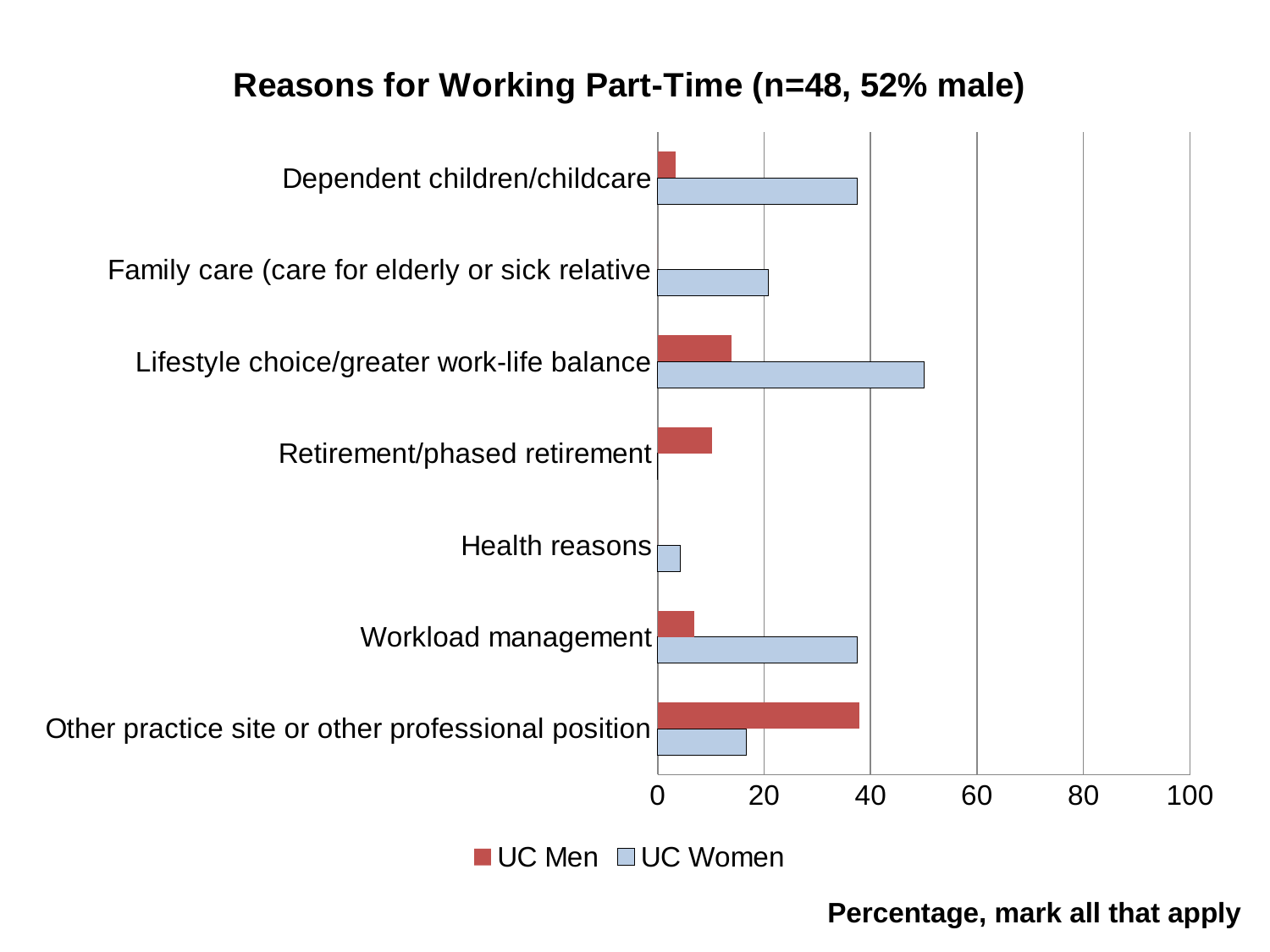
What is the title of the chart? Reasons for Working Part-Time (n=48, 52% male) For Dependent children/childcare, which is larger: UC Men or UC Women? UC Women Which reason has the highest value for UC Women? Lifestyle choice/greater work-life balance Is the UC Women value for Health reasons greater or less than 20? less Is the UC Women value for Lifestyle choice/greater work-life balance greater or less than 40? greater Which reason has the highest value for UC Men? Other practice site or other professional position What kind of chart is shown on the slide? bar chart How many series does the legend list? 2 How many reason categories are plotted on the chart? 7 Is the UC Men value for Other practice site or other professional position greater or less than 20? greater For Lifestyle choice/greater work-life balance, which is larger: UC Men or UC Women? UC Women For Other practice site or other professional position, which is larger: UC Men or UC Women? UC Men